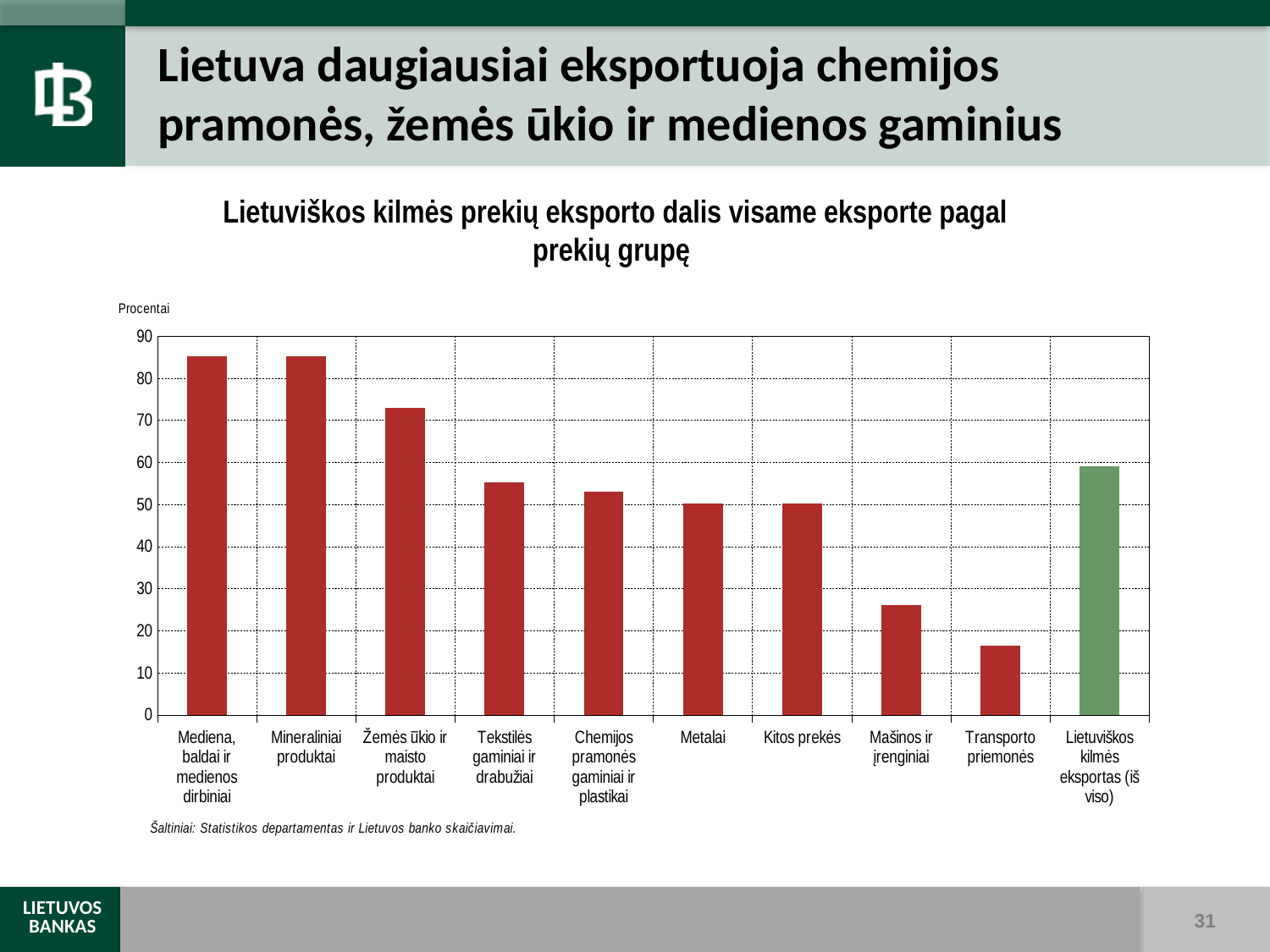
Which bar on the chart is coloured green rather than red? Lietuviškos kilmės eksportas (iš viso) Is the value for Transporto priemonės greater or less than 20? less Is the value for Mašinos ir įrenginiai greater or less than 30? less How many categories are plotted on the chart? 10 Which is larger, the value for Mašinos ir įrenginiai or the value for Transporto priemonės? Mašinos ir įrenginiai Is the value for Žemės ūkio ir maisto produktai greater or less than 70? greater What is the title of the chart? Lietuviškos kilmės prekių eksporto dalis visame eksporte pagal prekių grupę Which category has the lowest value on the chart? Transporto priemonės What kind of chart is shown on the slide? bar chart Which is larger, the value for Žemės ūkio ir maisto produktai or the value for Tekstilės gaminiai ir drabužiai? Žemės ūkio ir maisto produktai